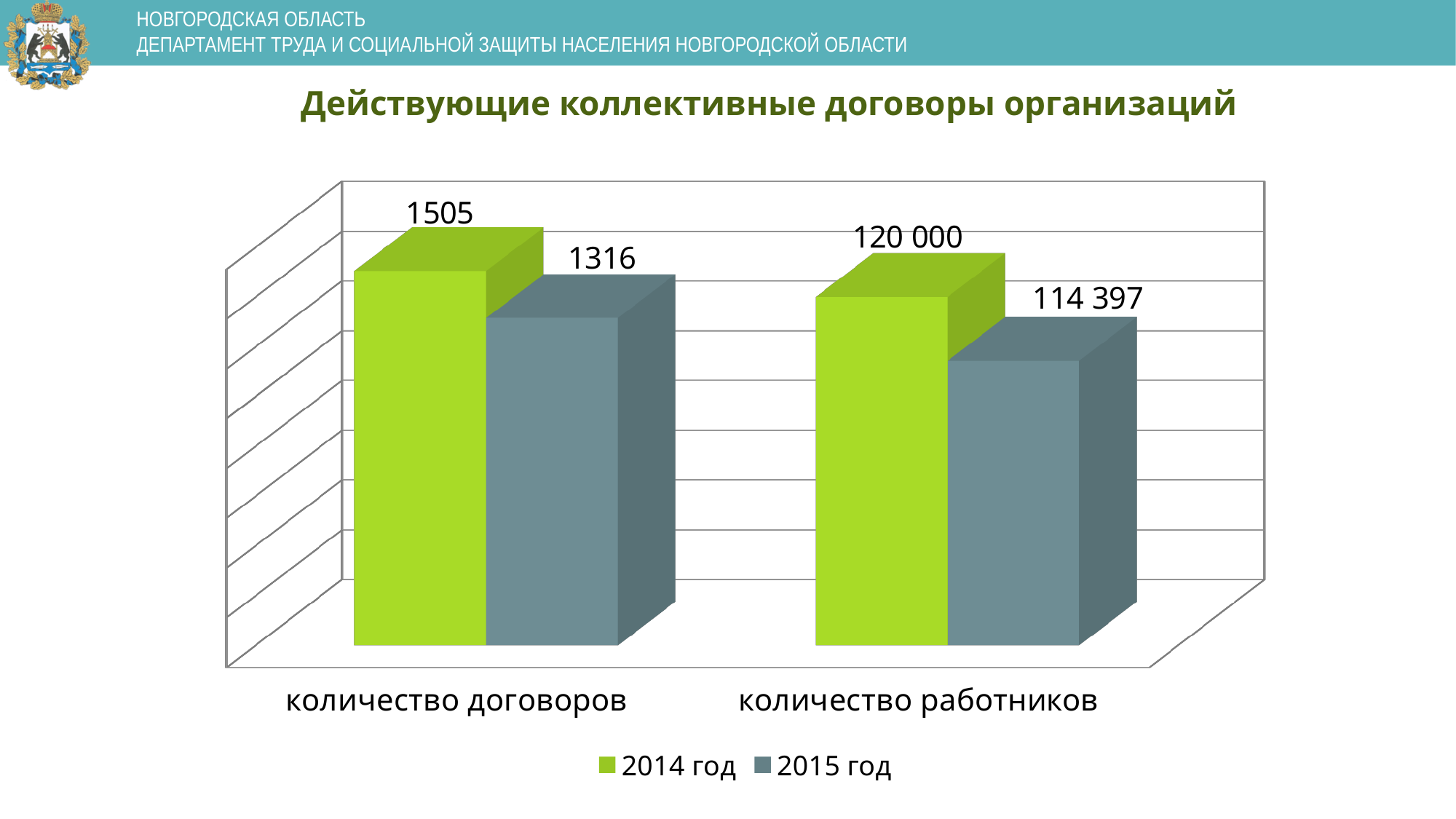
How many series does the legend list? 2 What is the value for 2014 год in the количество работников category? 120 000 What is the difference between the 2014 год and 2015 год values for количество работников? 5 603 Which year has the larger value for количество договоров, 2014 год or 2015 год? 2014 год What kind of chart is shown on the slide? Bar chart What is the value for 2014 год in the количество договоров category? 1505 What is the title of the chart on the slide? Действующие коллективные договоры организаций What is the value for 2015 год in the количество работников category? 114 397 What is the value for 2015 год in the количество договоров category? 1316 How many categories are shown on the x axis of the chart? 2 Which year has the smaller value for количество работников? 2015 год By how much did количество договоров decrease from 2014 год to 2015 год? 189